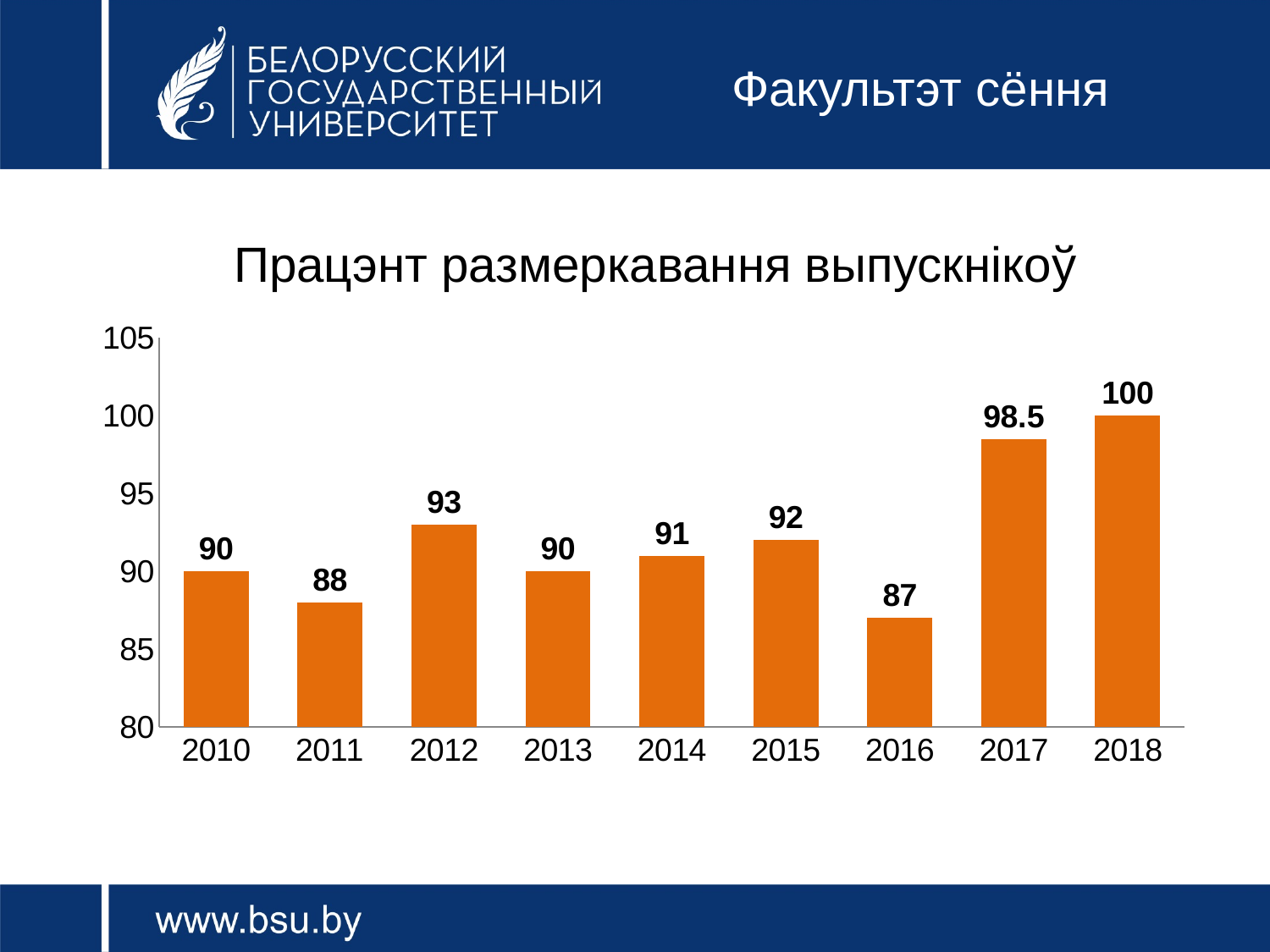
What kind of chart is this? bar chart What is the difference between the values for 2017 and 2011? 10.5 How many years are shown on the x axis? 9 What is the value for 2017? 98.5 What is the value for 2012? 93 Which is larger, the value for 2014 or the value for 2015? 2015 What is the difference between the values for 2018 and 2016? 13 Is the value for 2017 greater or less than 95? greater Which year has the lowest value? 2016 Which year has the highest value? 2018 What is the title of the chart? Працэнт размеркавання выпускнікоў What is the value for 2016? 87